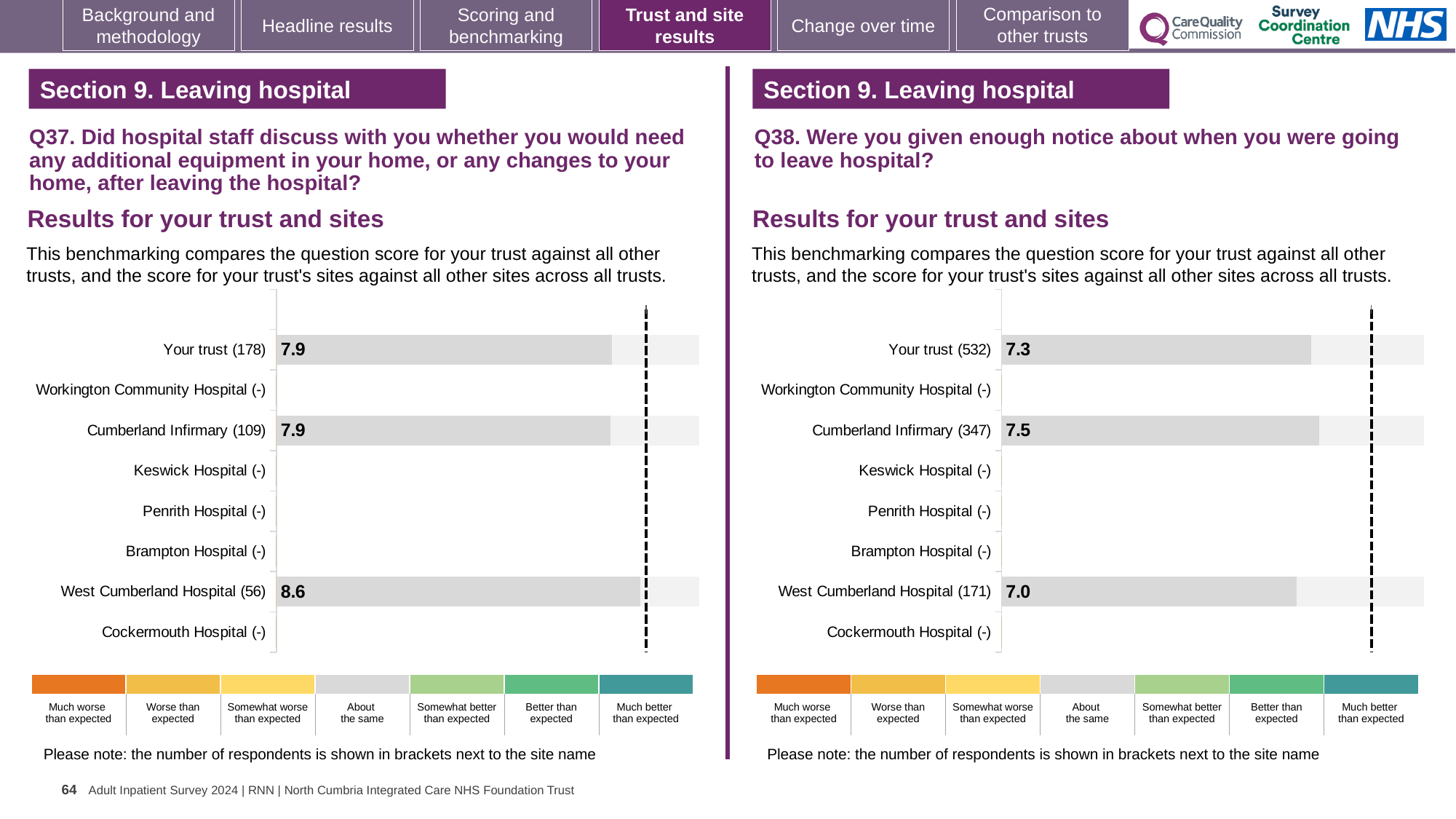
In the Q38 chart on the right, which site with a plotted score has the lowest value? West Cumberland Hospital In the Q37 chart on the left, which site with a plotted score has the highest value? West Cumberland Hospital In the Q37 chart on the left, what is the difference between the scores for West Cumberland Hospital and Cumberland Infirmary? 0.7 In the Q38 chart on the right, what is the score for West Cumberland Hospital? 7.0 In the Q37 chart on the left, what is the score for Your trust? 7.9 In the Q38 chart on the right, what is the score for Cumberland Infirmary? 7.5 In the Q37 chart on the left, what is the score for West Cumberland Hospital? 8.6 What type of chart is used in the Q38 chart on the right? Bar chart How many site rows (including Your trust) are listed in the Q37 chart on the left? 8 In the Q38 chart on the right, is the score for Cumberland Infirmary larger or smaller than the score for Your trust? larger In the Q38 chart on the right, what is the difference between the scores for Cumberland Infirmary and West Cumberland Hospital? 0.5 In the Q38 chart on the right, what is the score for Your trust? 7.3